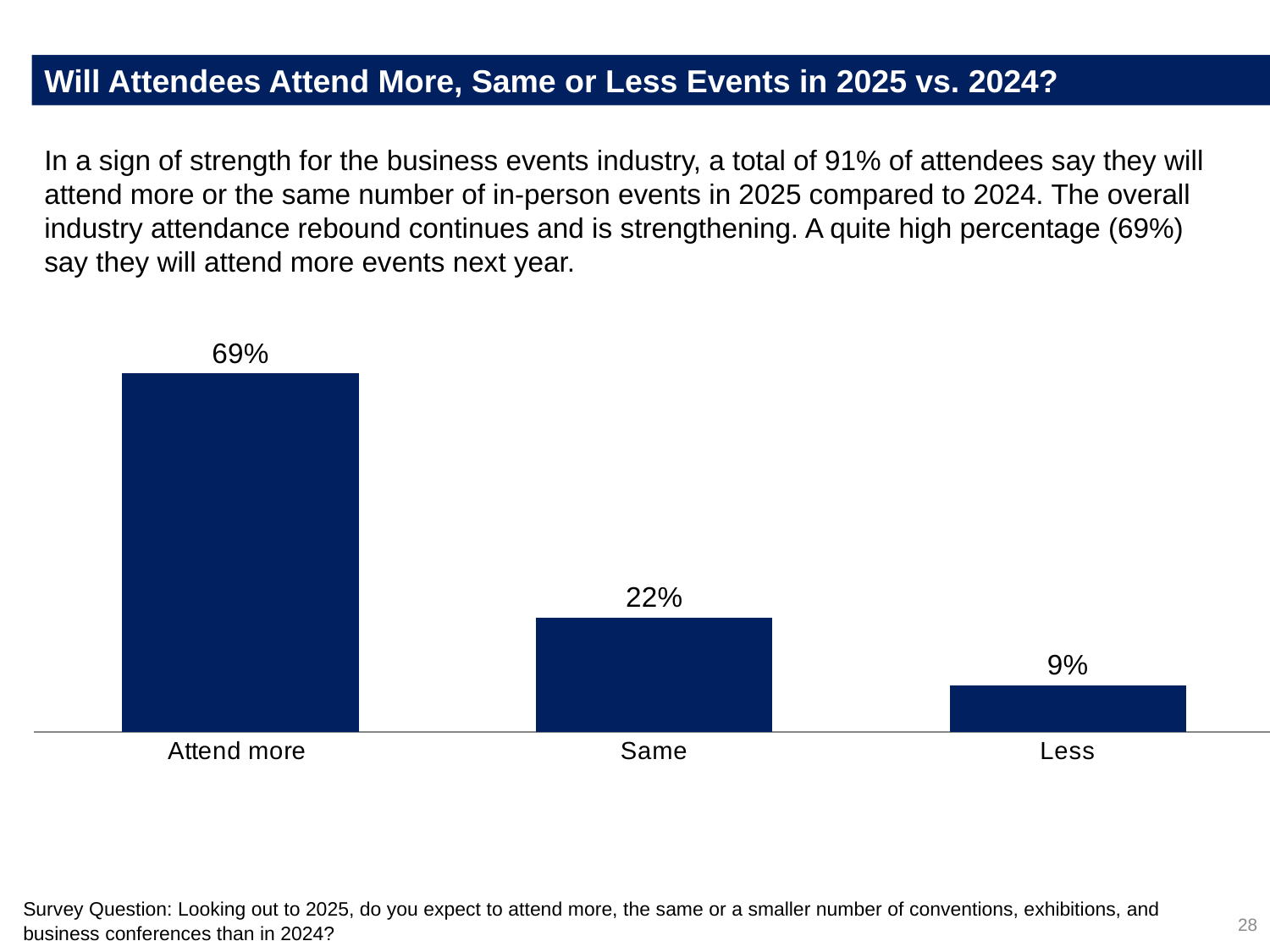
Which category has the highest value? Attend more What percentage of attendees say they will attend more events? 69% What is the value shown for the 'Less' category? 9% What is the combined value of 'Attend more' and 'Same'? 91% What is the difference between the 'Attend more' and 'Same' values? 47% Which category has the lowest value? Less What kind of chart is shown on the slide? Bar chart How many categories are shown in the chart? 3 Do the values rise or fall from left to right across the categories? Fall Which is larger, the value for 'Same' or the value for 'Less'? Same What is the difference between the 'Same' and 'Less' values? 13% What is the value shown for the 'Same' category? 22%